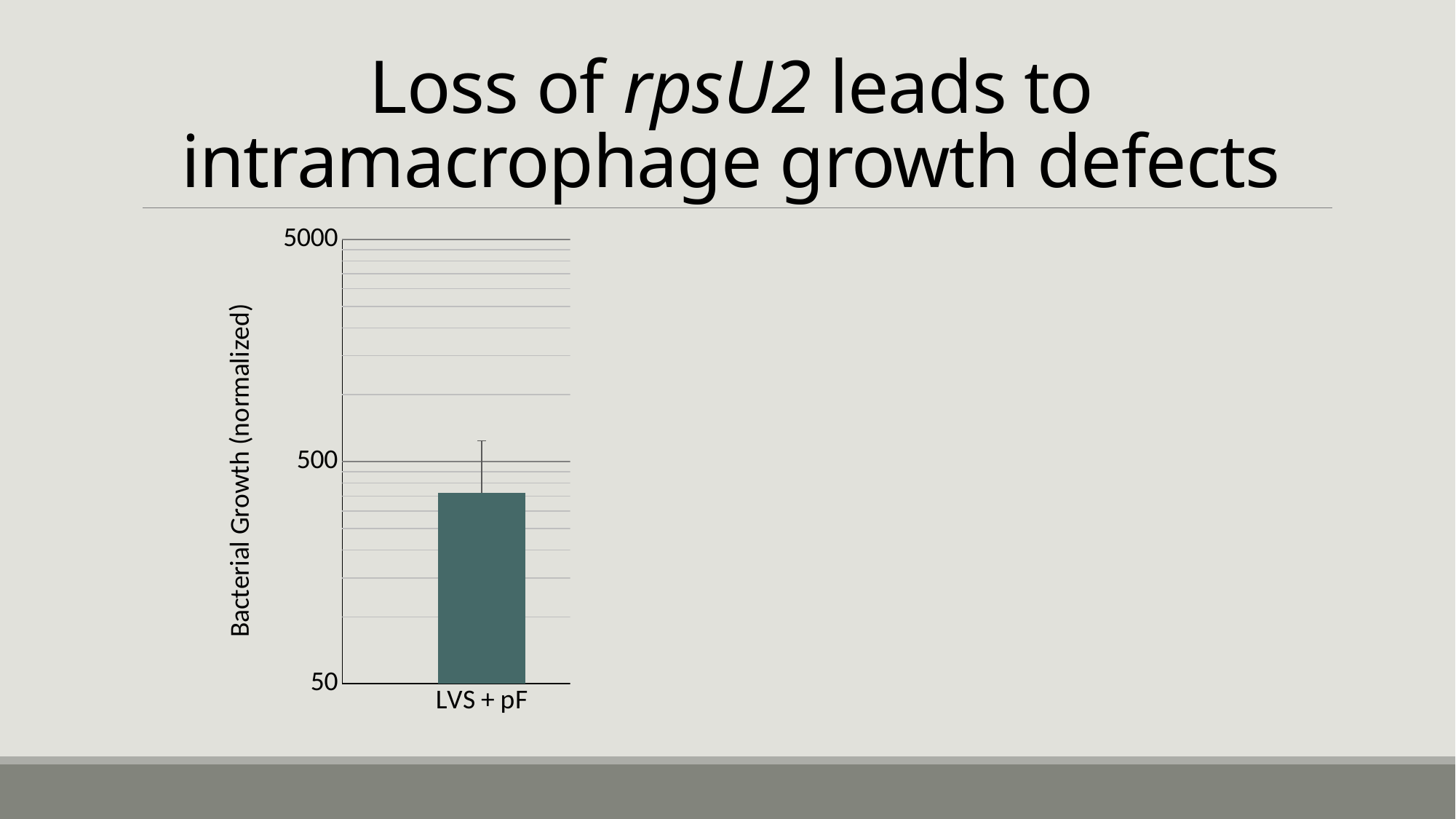
What is the highest tick value shown on the y axis? 5000 Is the value for LVS + pF greater or less than 500? less Is the value for LVS + pF greater or less than 50? greater How many bars are plotted in the chart? 1 What is the lowest tick value shown on the y axis? 50 What is the y-axis label of the chart? Bacterial Growth (normalized) What is the label of the only category on the x axis? LVS + pF What kind of chart is shown on the slide? bar chart